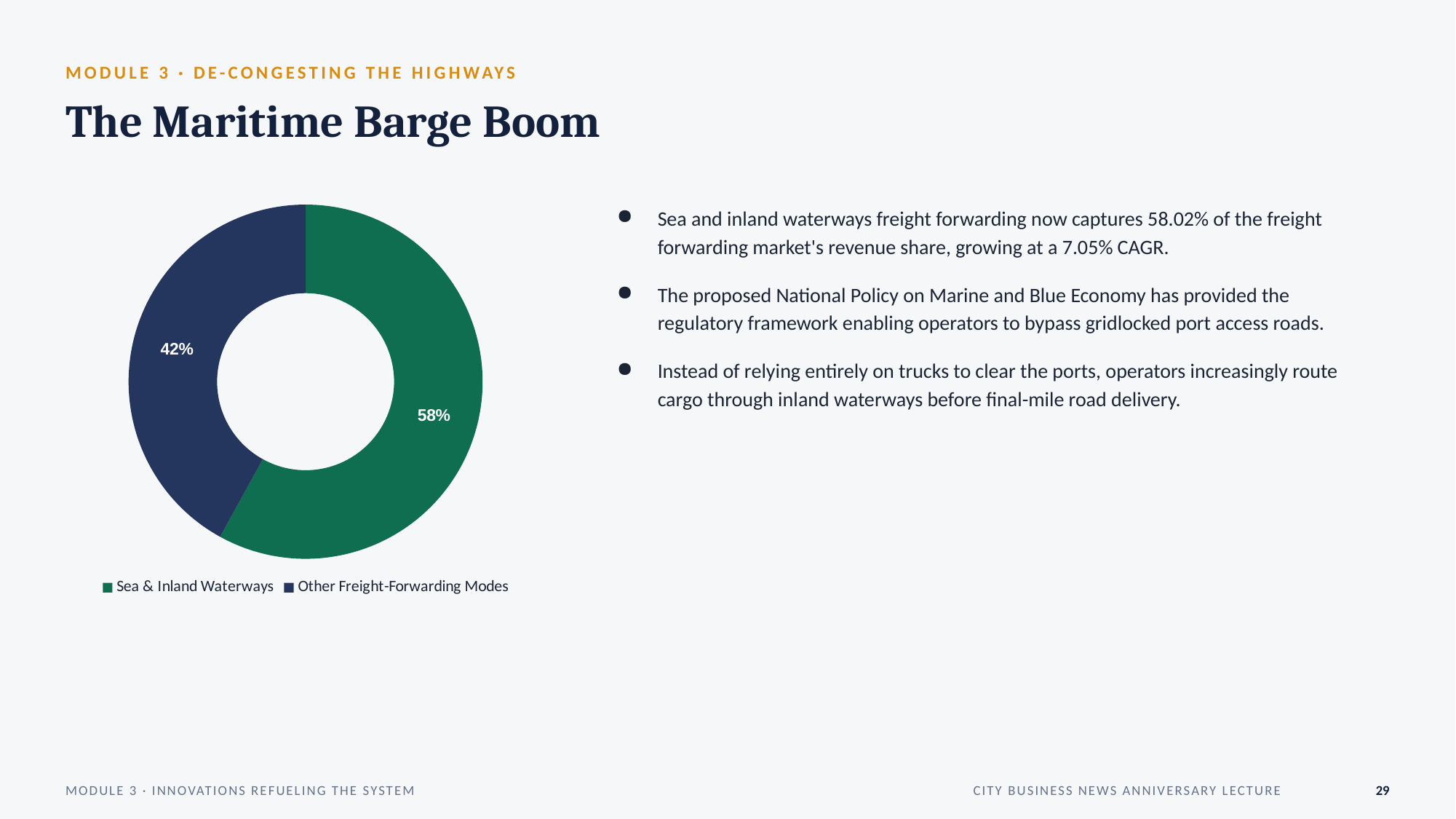
Which is larger: the Sea & Inland Waterways slice or the Other Freight-Forwarding Modes slice? Sea & Inland Waterways What colour is the Sea & Inland Waterways slice? Green What share of the pie does Other Freight-Forwarding Modes hold? 42% Which slice of the pie is the largest? Sea & Inland Waterways What kind of chart is shown on the slide? Pie chart (donut) Is the Sea & Inland Waterways slice more or less than half of the pie? More How many slices does the pie chart have? 2 What is the difference in percentage points between the Sea & Inland Waterways slice and the Other Freight-Forwarding Modes slice? 16 percentage points What share of the pie does Sea & Inland Waterways hold? 58% How many entries does the legend list? 2 Which slice of the pie is the smallest? Other Freight-Forwarding Modes What colour is the Other Freight-Forwarding Modes slice? Dark navy blue